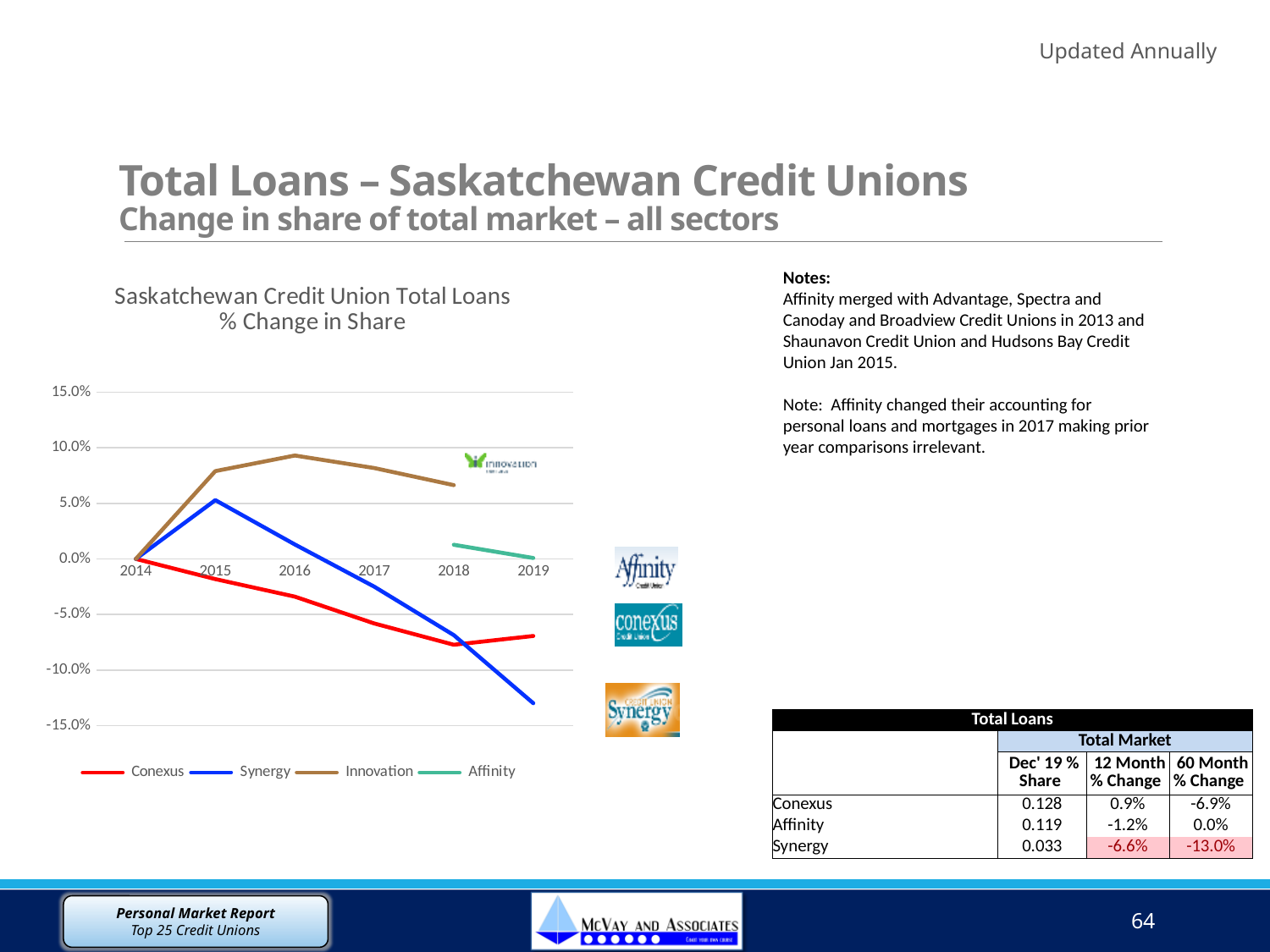
How many series does the chart legend list? 4 Is the value for Conexus in 2018 greater or less than -5.0%? less Does the Synergy line rise or fall from 2015 to 2019? fall Is the value for Innovation in 2018 greater or less than 5.0%? greater Is the value for Innovation in 2016 greater or less than 10.0%? less Which series has the highest value in 2016? Innovation In 2017, which series has the larger value, Innovation or Synergy? Innovation What colour is the Conexus line in the chart? red What kind of chart is shown on the slide? line chart How many years are shown on the x axis of the chart? 6 Which series has the lowest value in 2019? Synergy